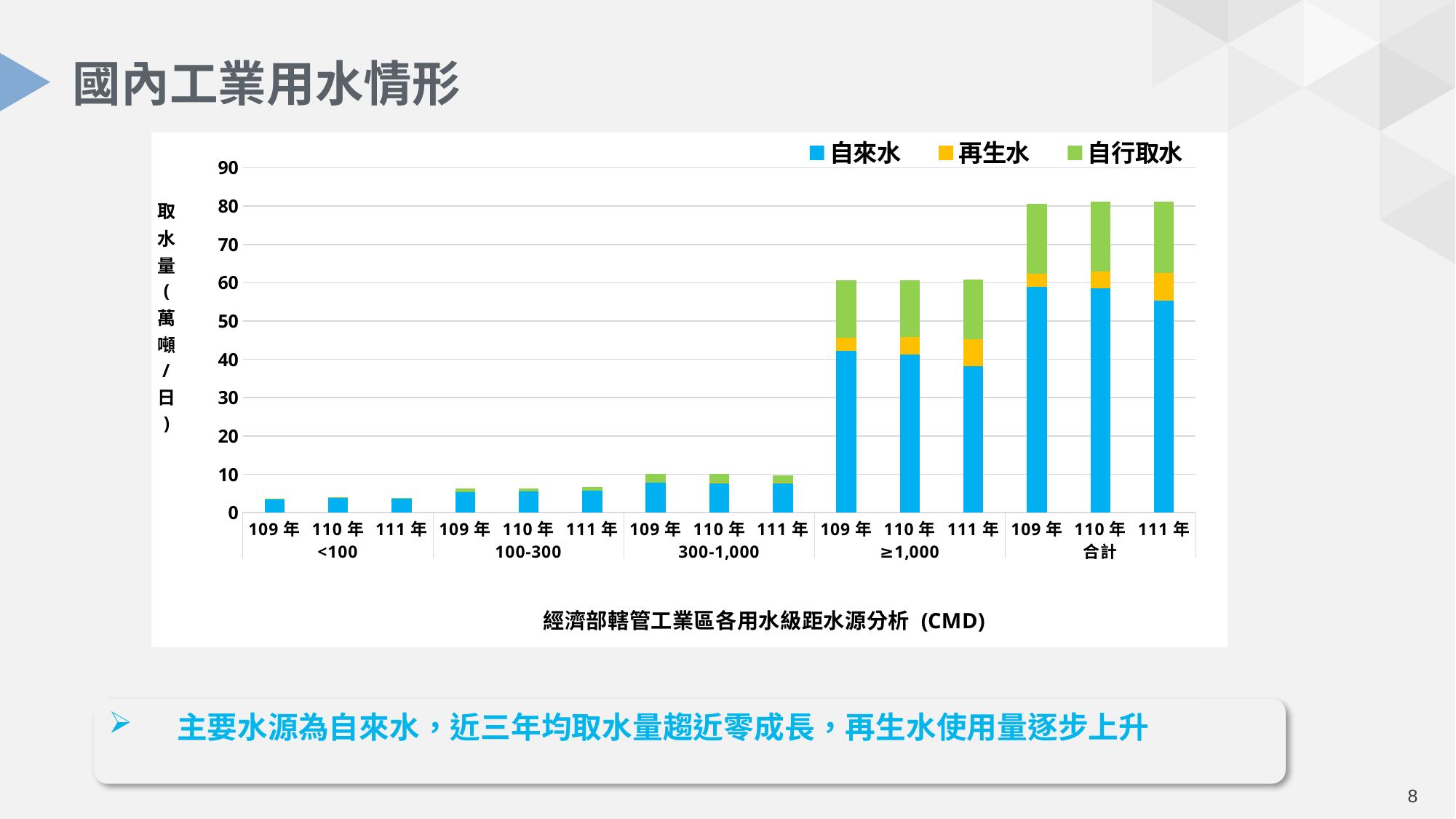
Is the total stacked value for 110 年 in the <100 group greater or less than 10? less Which x-axis group has the shortest stacked bars? <100 How many series does the legend list? 3 Is the total stacked value for 109 年 in the 合計 group greater or less than 70? greater How many water-use groups (x-axis groups) are shown in the chart? 5 Is the total stacked value for 111 年 in the ≥1,000 group greater or less than 50? greater How many stacked bars are plotted in the chart? 15 Which x-axis group has the tallest stacked bars? 合計 What is the title printed below the chart? 經濟部轄管工業區各用水級距水源分析 (CMD) Which is larger: the total stacked bar for 109 年 in the 合計 group or for 109 年 in the ≥1,000 group? 109 年 in the 合計 group What are the three series listed in the legend? 自來水, 再生水, 自行取水 What kind of chart is shown on the slide? stacked bar chart